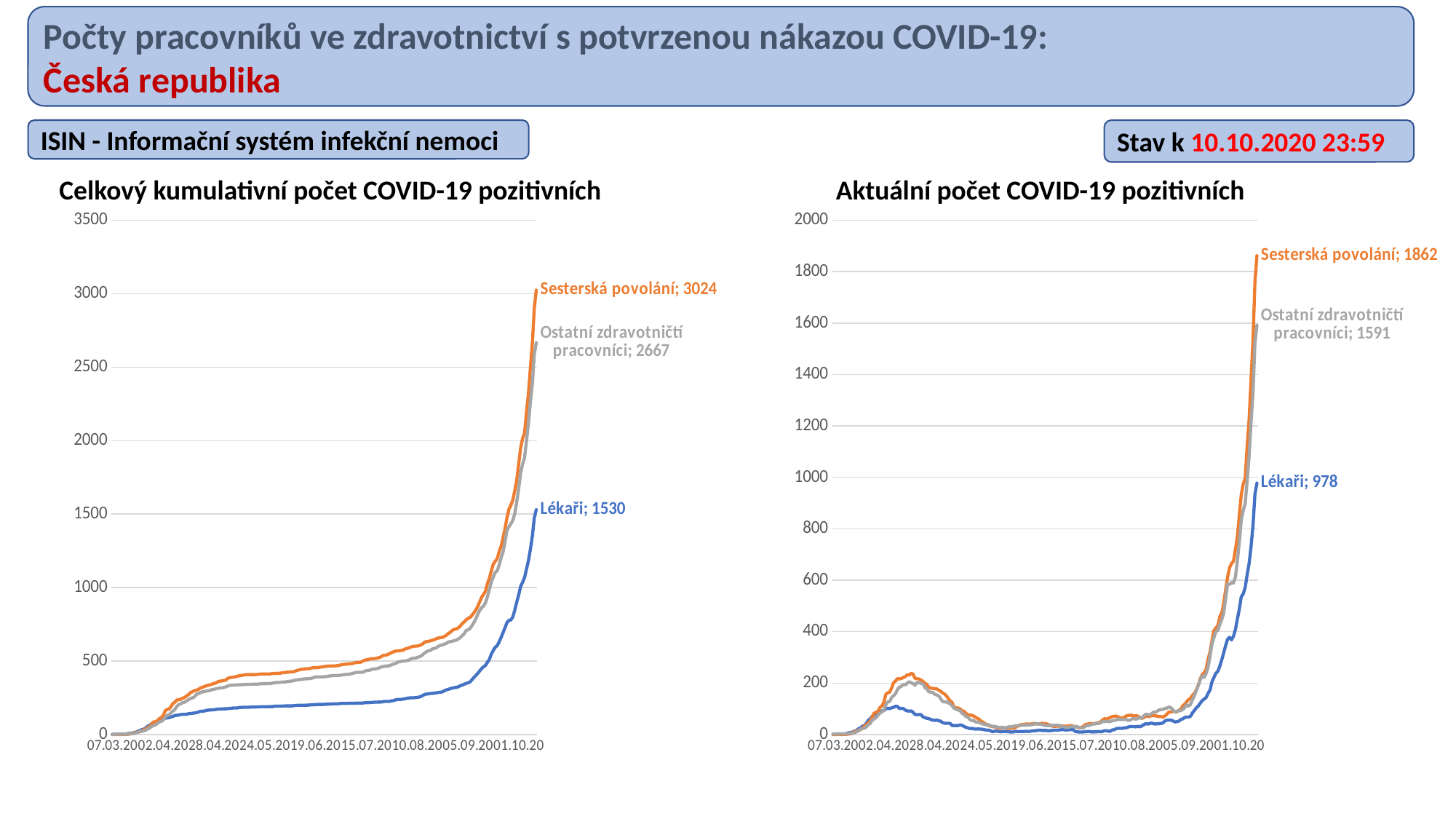
In the chart titled "Aktuální počet COVID-19 pozitivních", what is the difference between the final values for Sesterská povolání and Ostatní zdravotničtí pracovníci? 271 In the chart titled "Celkový kumulativní počet COVID-19 pozitivních", what is the final value labelled for Ostatní zdravotničtí pracovníci? 2667 In the chart titled "Aktuální počet COVID-19 pozitivních", which series has the highest final labelled value? Sesterská povolání What kind of chart is the chart titled "Celkový kumulativní počet COVID-19 pozitivních"? Line chart In the chart titled "Aktuální počet COVID-19 pozitivních", what is the final value labelled for Sesterská povolání? 1862 In the chart titled "Aktuální počet COVID-19 pozitivních", what is the final value labelled for Lékaři? 978 In the chart titled "Celkový kumulativní počet COVID-19 pozitivních", what is the final value labelled for Sesterská povolání? 3024 In the chart titled "Celkový kumulativní počet COVID-19 pozitivních", which series has the lowest final labelled value? Lékaři In the chart titled "Celkový kumulativní počet COVID-19 pozitivních", what is the final value labelled for Lékaři? 1530 In the chart titled "Aktuální počet COVID-19 pozitivních", which is larger: the final value for Ostatní zdravotničtí pracovníci or for Lékaři? Ostatní zdravotničtí pracovníci In the chart titled "Celkový kumulativní počet COVID-19 pozitivních", what is the difference between the final values for Sesterská povolání and Lékaři? 1494 How many series are plotted in the chart titled "Aktuální počet COVID-19 pozitivních"? 3